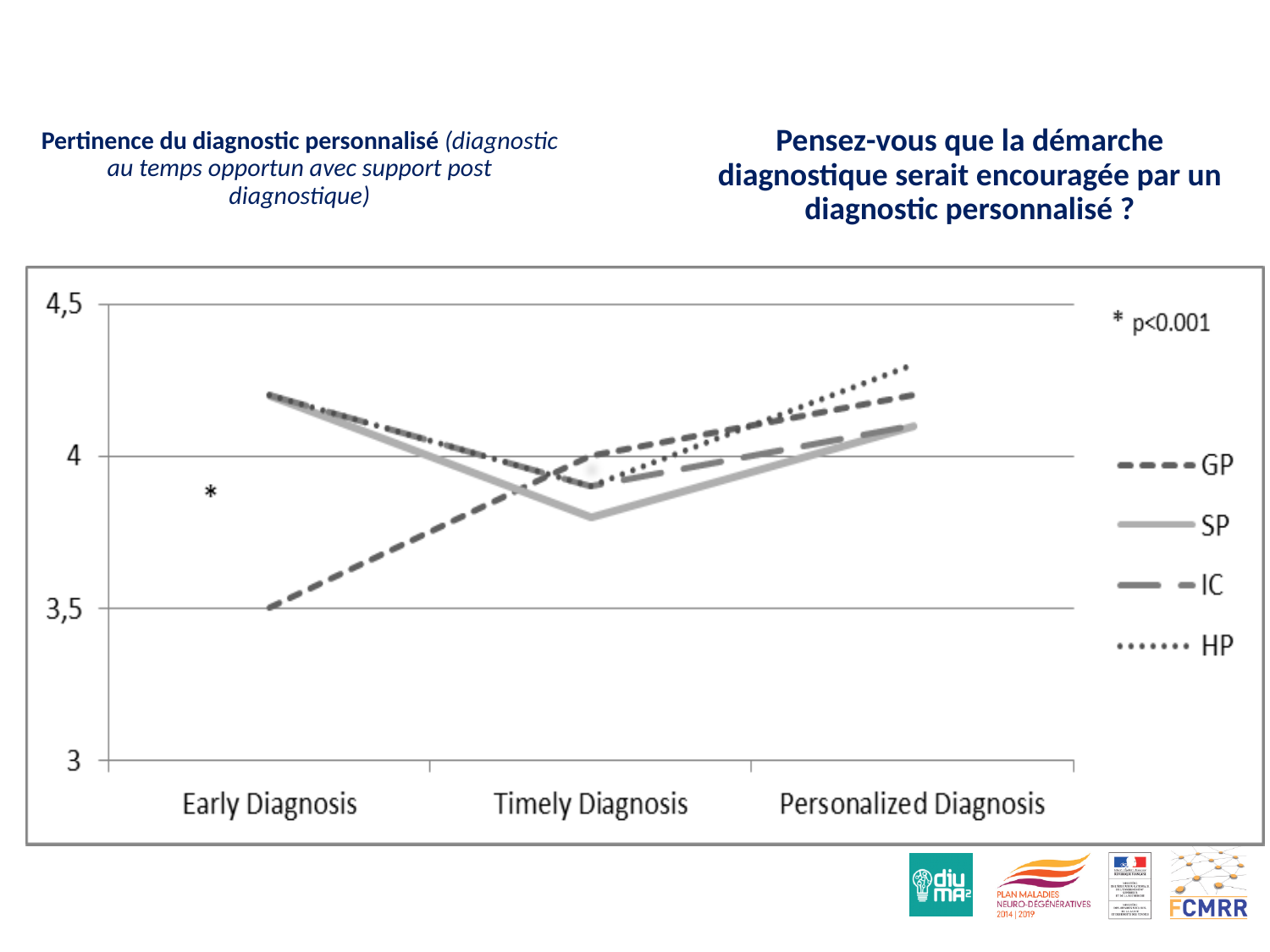
Which series has the highest value at Personalized Diagnosis? HP Is the value for SP at Timely Diagnosis greater or less than 4? less Is the value for HP at Personalized Diagnosis greater or less than 4? greater How many categories are shown on the x axis? 3 What is the value for GP at Early Diagnosis? 3,5 Which series has the lowest value at Timely Diagnosis? SP Which series has the lowest value at Early Diagnosis? GP What does the asterisk annotation in the chart indicate? p<0.001 What kind of chart is shown on the slide? line chart Does the GP series rise or fall from Early Diagnosis to Personalized Diagnosis? rise Is the value for SP at Early Diagnosis greater or less than 4? greater How many series does the legend list? 4